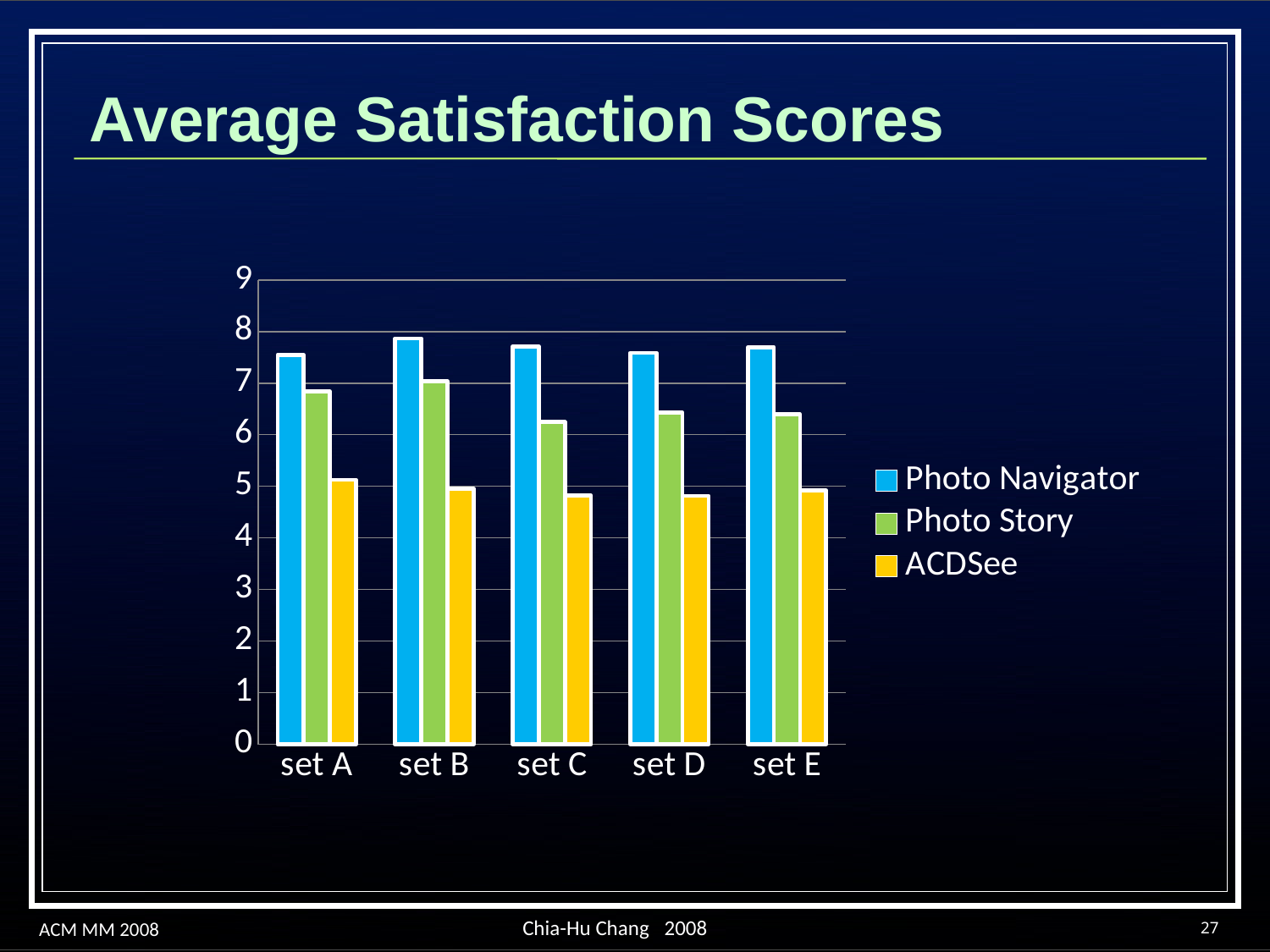
Which series is shown in yellow? ACDSee What kind of chart is shown on the slide? bar chart What is the title of the chart? Average Satisfaction Scores Is the Photo Story value for set C greater or less than 6? greater For which set is the ACDSee score highest? set A How many series does the legend list? 3 For set A, which is larger: Photo Navigator or ACDSee? Photo Navigator Is the Photo Navigator value for set A greater or less than 7? greater How many photo sets are shown on the x axis? 5 Is the Photo Navigator value for set B greater or less than 8? less For which set is the Photo Story score highest? set B